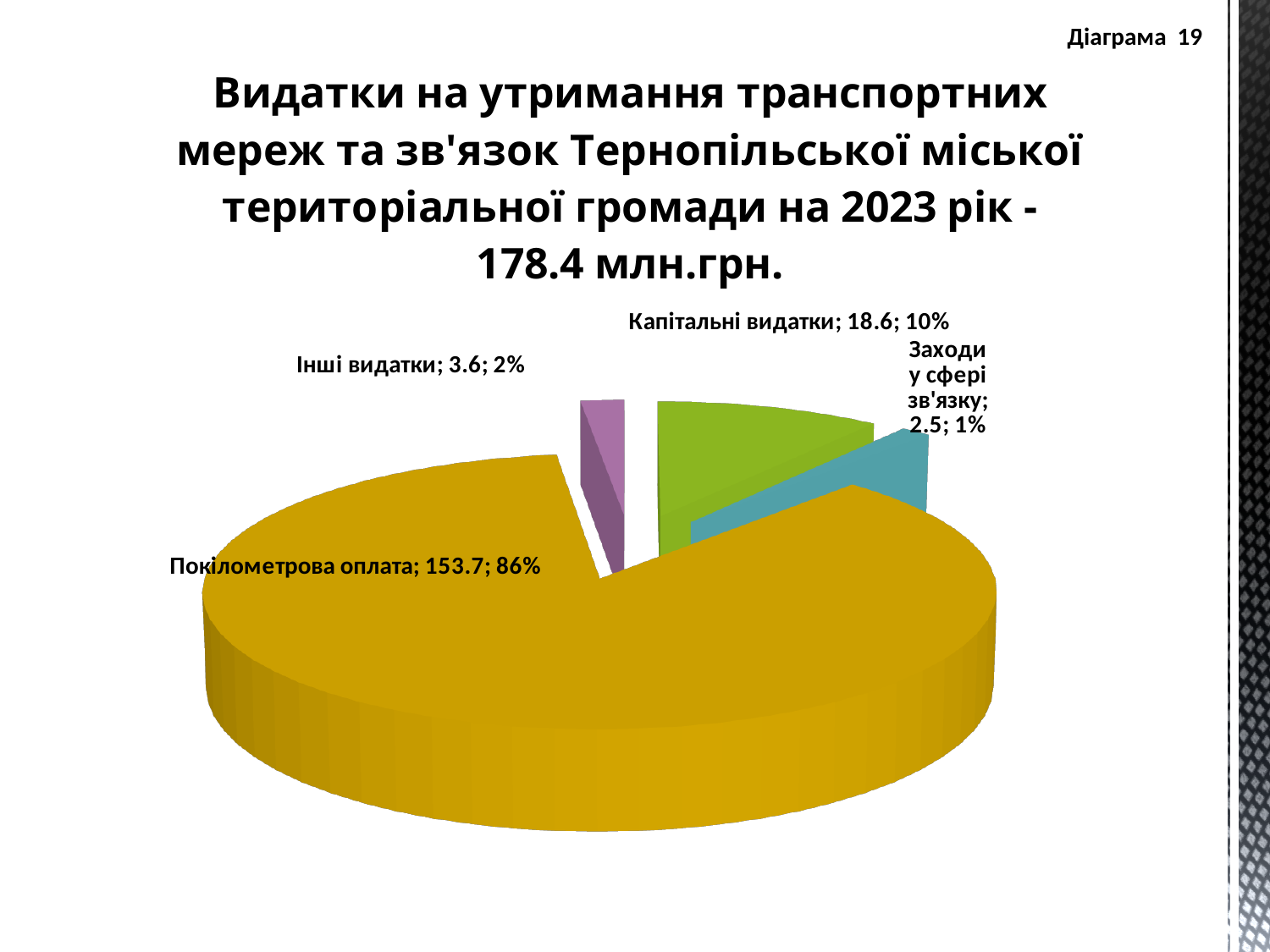
What is the value for Покілометрова оплата? 153.7 What share of the pie does Капітальні видатки represent? 10% Which category has the smallest slice of the pie? Заходи у сфері зв'язку What is the value for Капітальні видатки? 18.6 What is the value for Заходи у сфері зв'язку? 2.5 What is the value for Інші видатки? 3.6 Which category has the largest slice of the pie? Покілометрова оплата How many slices does the pie chart have? 4 What is the difference between the values for Капітальні видатки and Інші видатки? 15 What share of the pie does Покілометрова оплата represent? 86% What type of chart is shown on the slide? Pie chart Which is larger, the value for Інші видатки or the value for Заходи у сфері зв'язку? Інші видатки